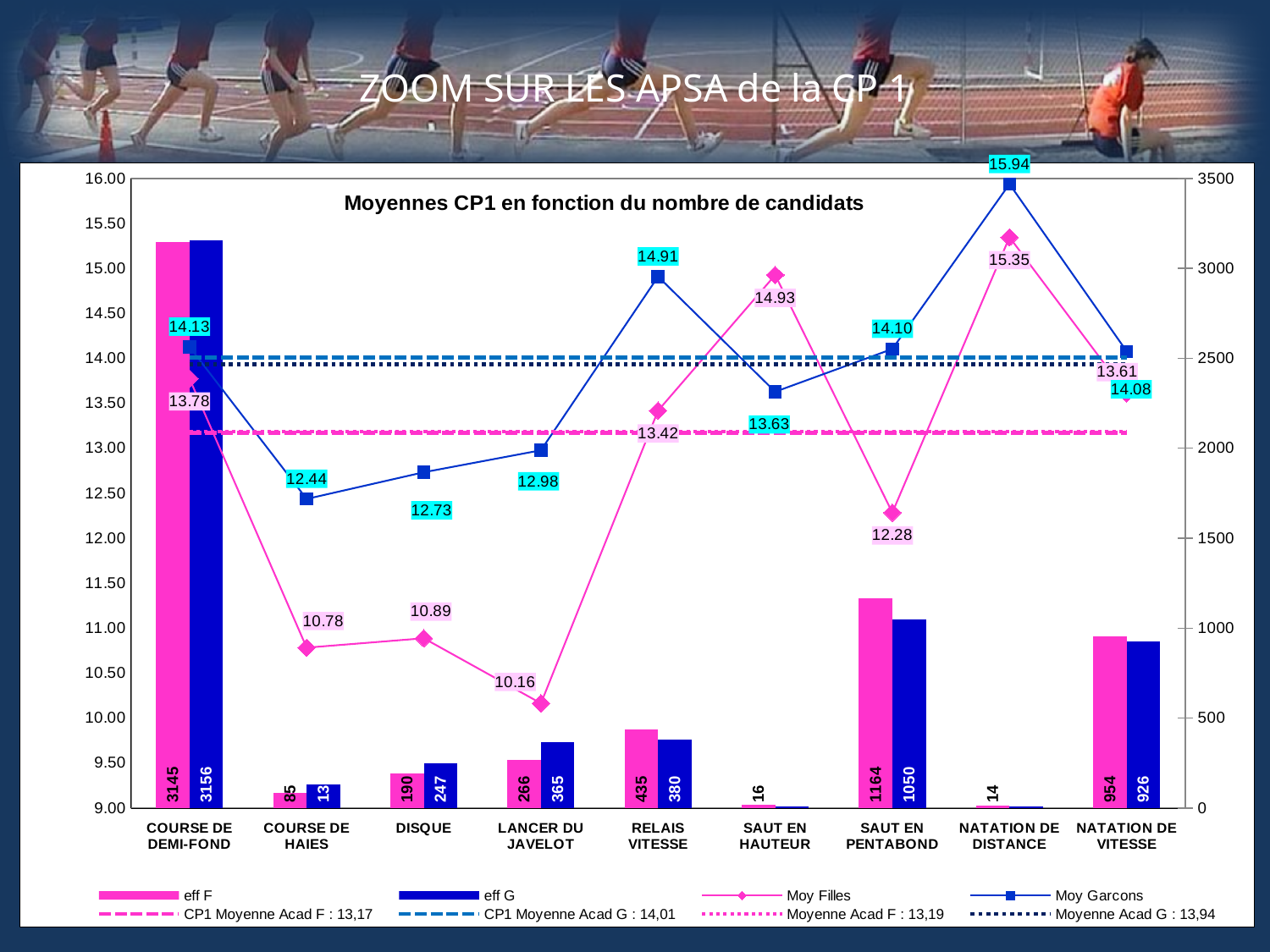
For SAUT EN HAUTEUR, which is larger: Moy Filles or Moy Garcons? Moy Filles What is the Moy Garcons value for NATATION DE DISTANCE? 15.94 How many categories are shown on the x axis? 9 What is the eff F value for COURSE DE DEMI-FOND? 3145 What is the eff G value for SAUT EN PENTABOND? 1050 How many series does the legend list? 8 Which category has the highest eff F value? COURSE DE DEMI-FOND Which category has the lowest Moy Filles value? LANCER DU JAVELOT What is the difference between Moy Garcons and Moy Filles for COURSE DE HAIES? 1.66 What is the difference between eff F and eff G for RELAIS VITESSE? 55 What is the Moy Filles value for LANCER DU JAVELOT? 10.16 Which category has the highest Moy Filles value? NATATION DE DISTANCE